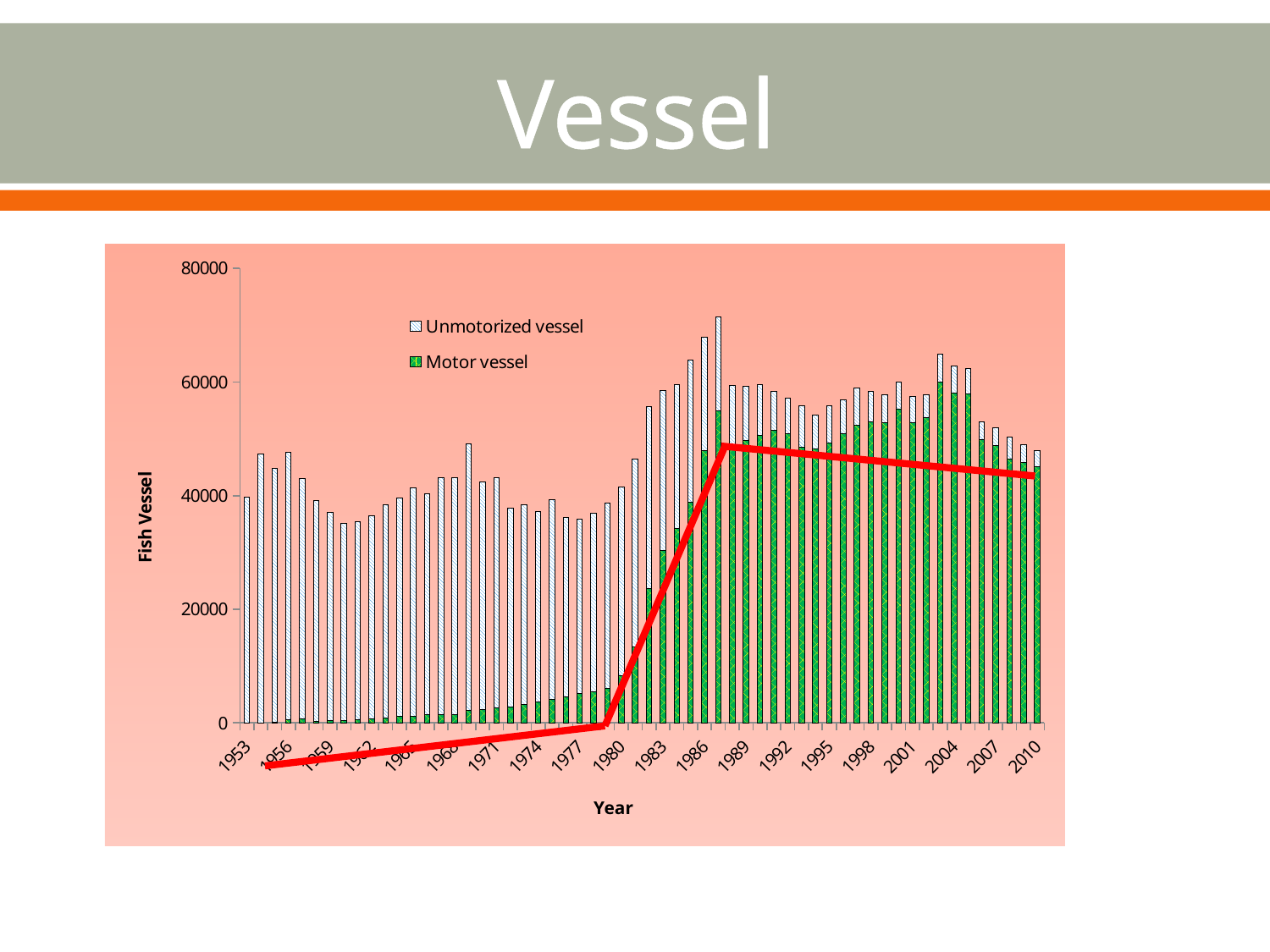
Is the number of motor vessels in 2004 greater or less than 40000? greater What kind of chart is shown on the slide? Stacked bar chart Is the number of motor vessels in 1953 greater or less than 20000? less What is the label of the vertical axis? Fish Vessel Is the total number of fish vessels in 2010 greater or less than 60000? less How many series does the legend list? 2 How many year labels are shown on the x axis? 20 Which year has the larger total number of fish vessels, 1986 or 2010? 1986 What are the two series named in the legend? Unmotorized vessel and Motor vessel Does the number of motor vessels rise or fall from 1953 to 2010? rise